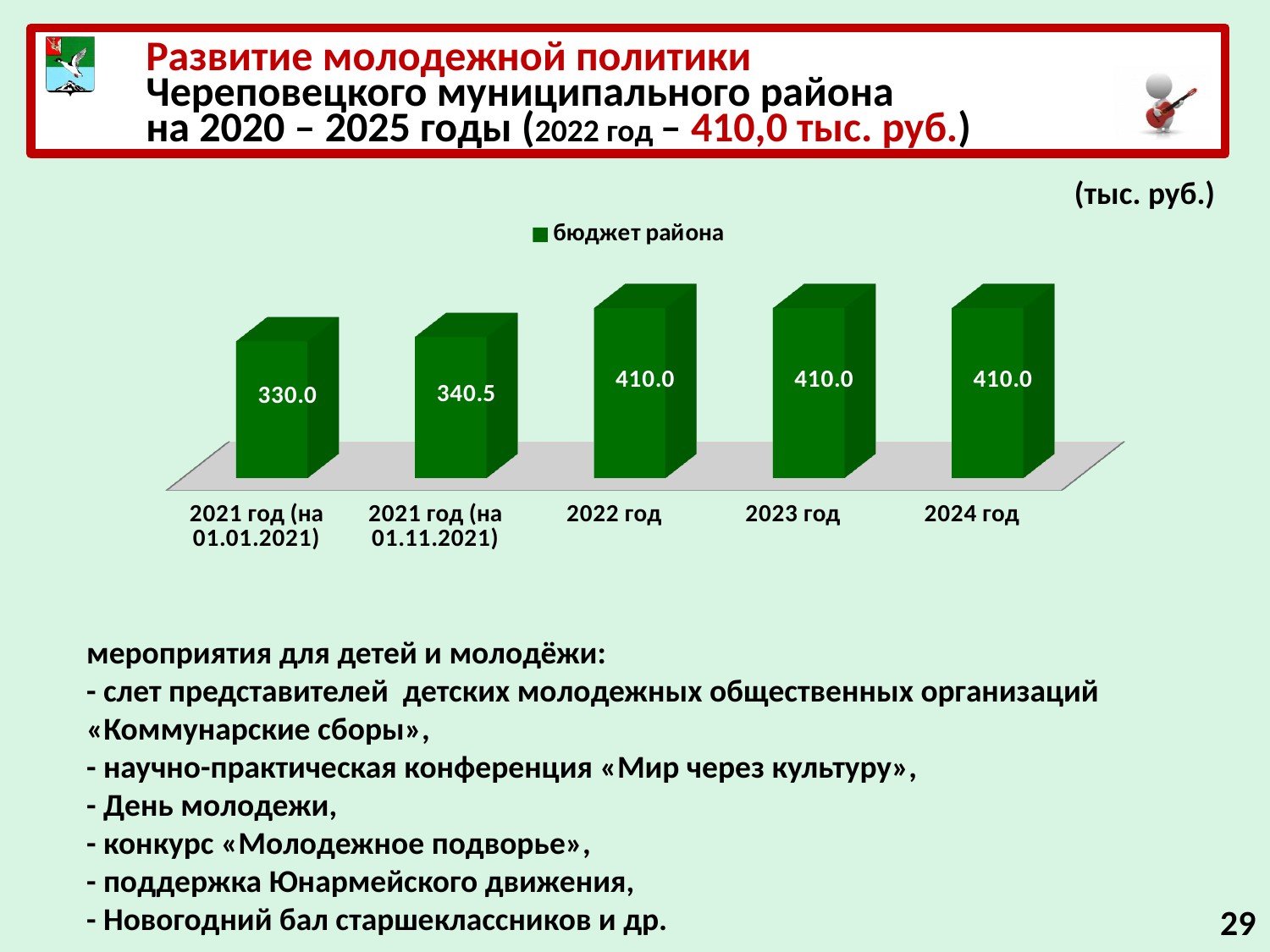
Which is larger, the value for 2023 год or the value for 2021 год (на 01.11.2021)? 2023 год How many categories are shown on the x axis? 5 Which category has the lowest value? 2021 год (на 01.01.2021) What is the value for 2022 год? 410.0 What is the difference between the values for 2022 год and 2021 год (на 01.01.2021)? 80.0 How many series does the legend list? 1 What is the value for 2021 год (на 01.01.2021)? 330.0 What is the difference between the values for 2021 год (на 01.11.2021) and 2021 год (на 01.01.2021)? 10.5 What is the name of the series in the legend? бюджет района What kind of chart is shown on the slide? bar chart What is the value for 2024 год? 410.0 What is the value for 2021 год (на 01.11.2021)? 340.5